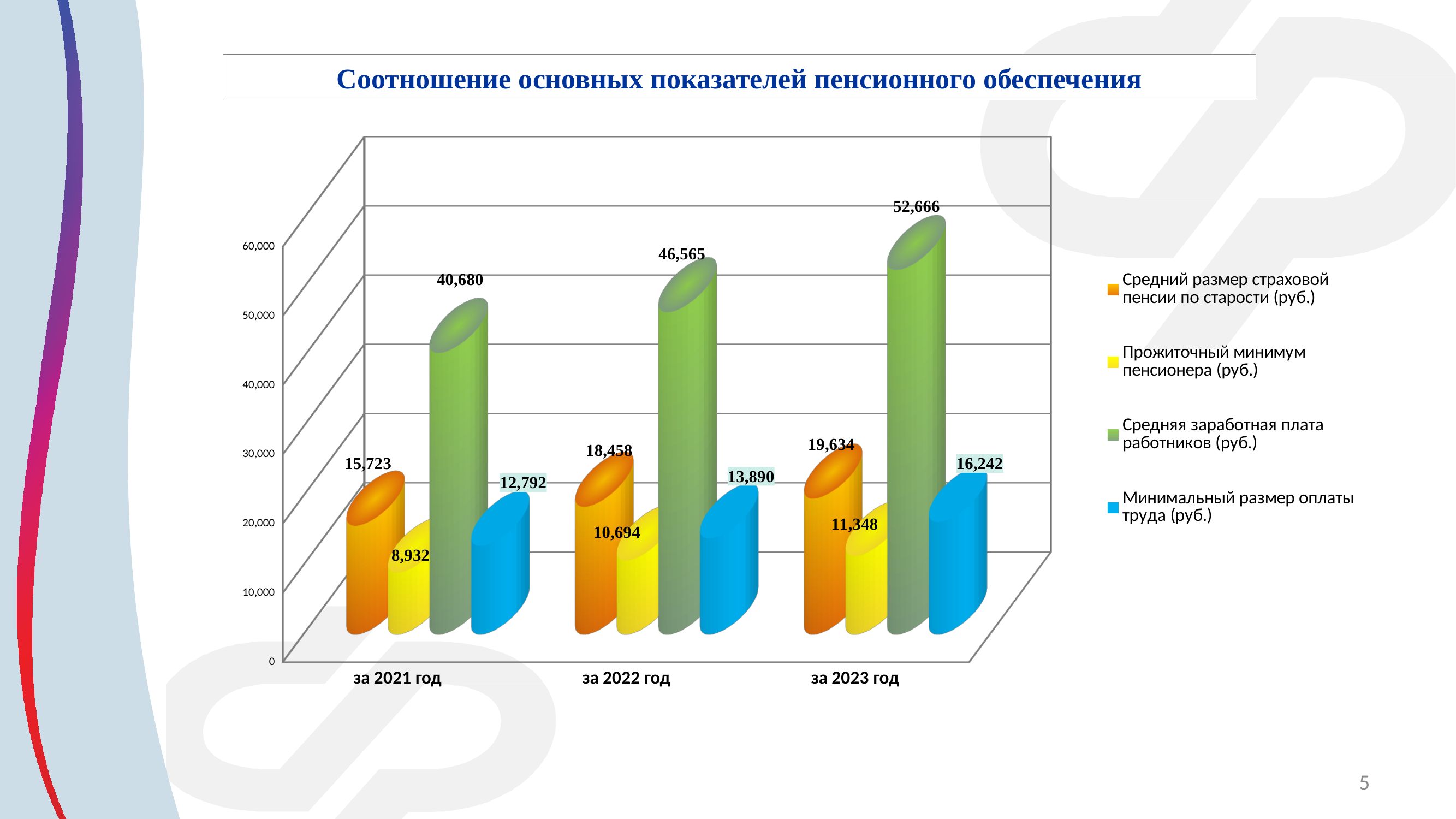
What is the value of Минимальный размер оплаты труда (руб.) for за 2023 год? 16,242 What is the value of Прожиточный минимум пенсионера (руб.) for за 2022 год? 10,694 Which is larger for за 2022 год: Средний размер страховой пенсии по старости (руб.) or Минимальный размер оплаты труда (руб.)? Средний размер страховой пенсии по старости (руб.) Does Минимальный размер оплаты труда (руб.) rise or fall from за 2021 год to за 2023 год? rise What is the value of Средняя заработная плата работников (руб.) for за 2023 год? 52,666 What is the difference between Средняя заработная плата работников (руб.) for за 2023 год and за 2021 год? 11,986 What is the value of Средний размер страховой пенсии по старости (руб.) for за 2021 год? 15,723 How many series does the legend list? 4 In which year is Прожиточный минимум пенсионера (руб.) the lowest? за 2021 год What is the difference between Средний размер страховой пенсии по старости (руб.) for за 2023 год and за 2021 год? 3,911 In which year is Средняя заработная плата работников (руб.) the highest? за 2023 год How many years (categories) are shown on the x axis? 3